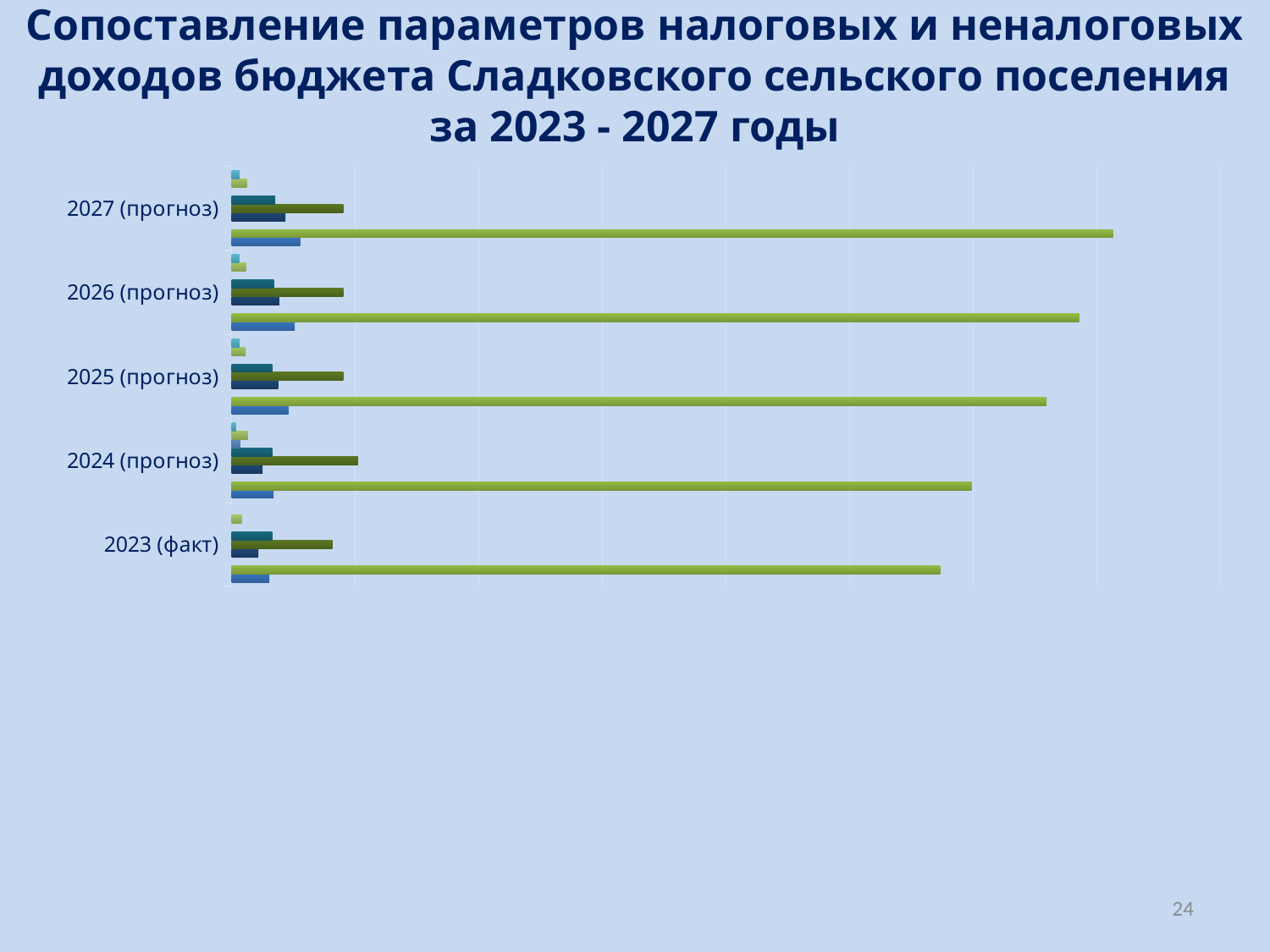
Does the longest (light green) bar in each category rise or fall from 2023 (факт) to 2027 (прогноз)? Rise Is the longest bar for 2027 (прогноз) longer or shorter than the longest bar for 2023 (факт)? Longer How many year categories are shown on the chart? 5 Which year category has the longest bar on the chart? 2027 (прогноз) What kind of chart is shown on the slide? Bar chart Are the bars on the chart oriented horizontally or vertically? Horizontally Which category appears at the top of the chart? 2027 (прогноз) Is the longest bar for 2025 (прогноз) longer or shorter than the longest bar for 2026 (прогноз)? Shorter Which year category has the shortest longest-bar on the chart? 2023 (факт) Which category is labelled as actual (факт) rather than forecast (прогноз)? 2023 (факт)